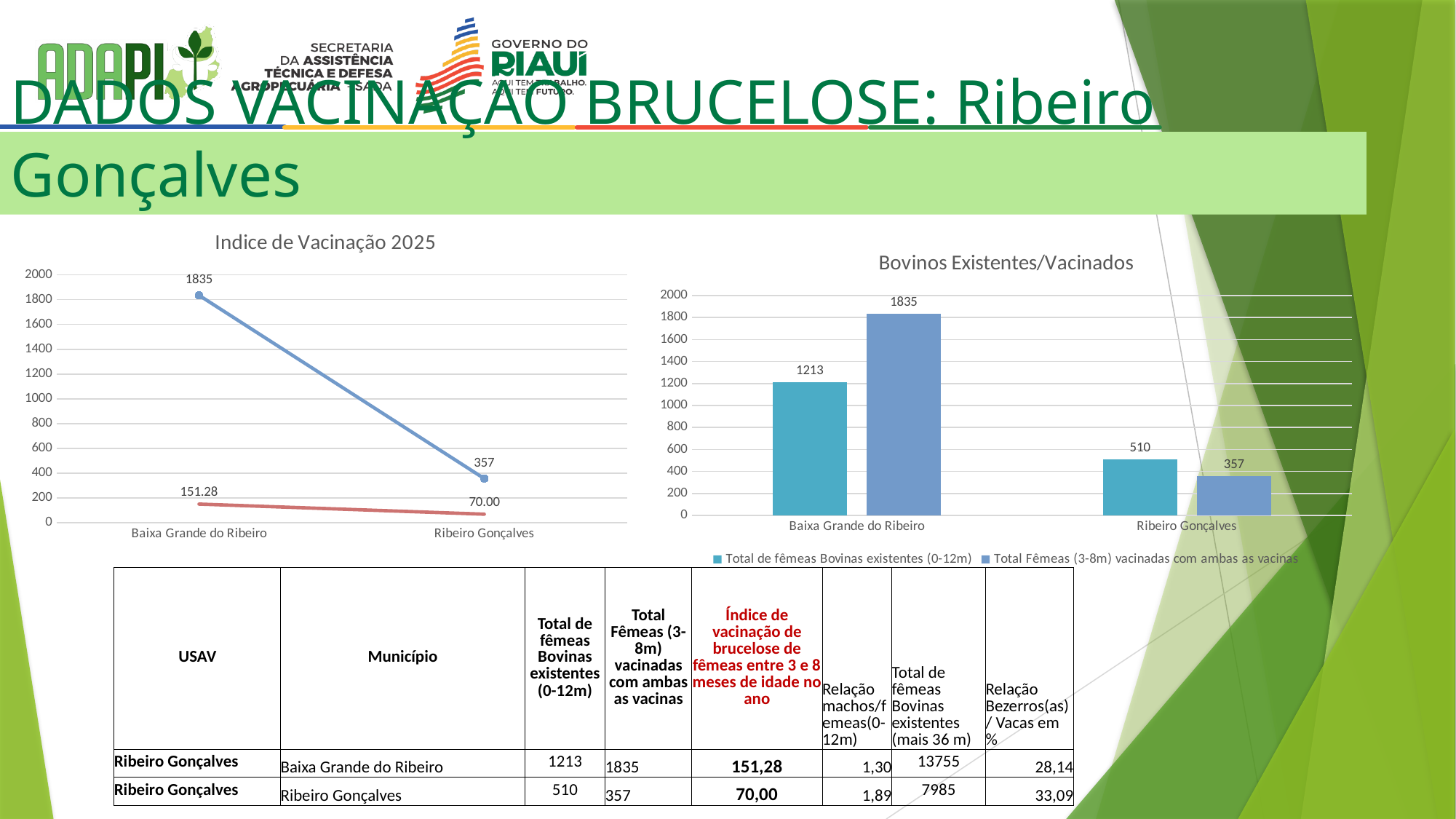
In the 'Indice de Vacinação 2025' chart, what is the value of the red line at Baixa Grande do Ribeiro? 151.28 What kind of chart is 'Bovinos Existentes/Vacinados'? Bar chart In the 'Bovinos Existentes/Vacinados' chart, what is the value of 'Total de fêmeas Bovinas existentes (0-12m)' for Ribeiro Gonçalves? 510 In the 'Indice de Vacinação 2025' chart, what is the value of the red line at Ribeiro Gonçalves? 70.00 In the 'Bovinos Existentes/Vacinados' chart, what is the value of 'Total de fêmeas Bovinas existentes (0-12m)' for Baixa Grande do Ribeiro? 1213 In the 'Bovinos Existentes/Vacinados' chart, what is the value of 'Total Fêmeas (3-8m) vacinadas com ambas as vacinas' for Ribeiro Gonçalves? 357 What kind of chart is 'Indice de Vacinação 2025'? Line chart In the 'Bovinos Existentes/Vacinados' chart, what is the difference between the two bars for Baixa Grande do Ribeiro? 622 In the 'Bovinos Existentes/Vacinados' chart, how many series does the legend list? 2 In the 'Indice de Vacinação 2025' chart, does the blue line rise or fall from Baixa Grande do Ribeiro to Ribeiro Gonçalves? Fall In the 'Indice de Vacinação 2025' chart, what is the value of the blue line at Ribeiro Gonçalves? 357 In the 'Bovinos Existentes/Vacinados' chart, which category has the highest value for 'Total Fêmeas (3-8m) vacinadas com ambas as vacinas'? Baixa Grande do Ribeiro